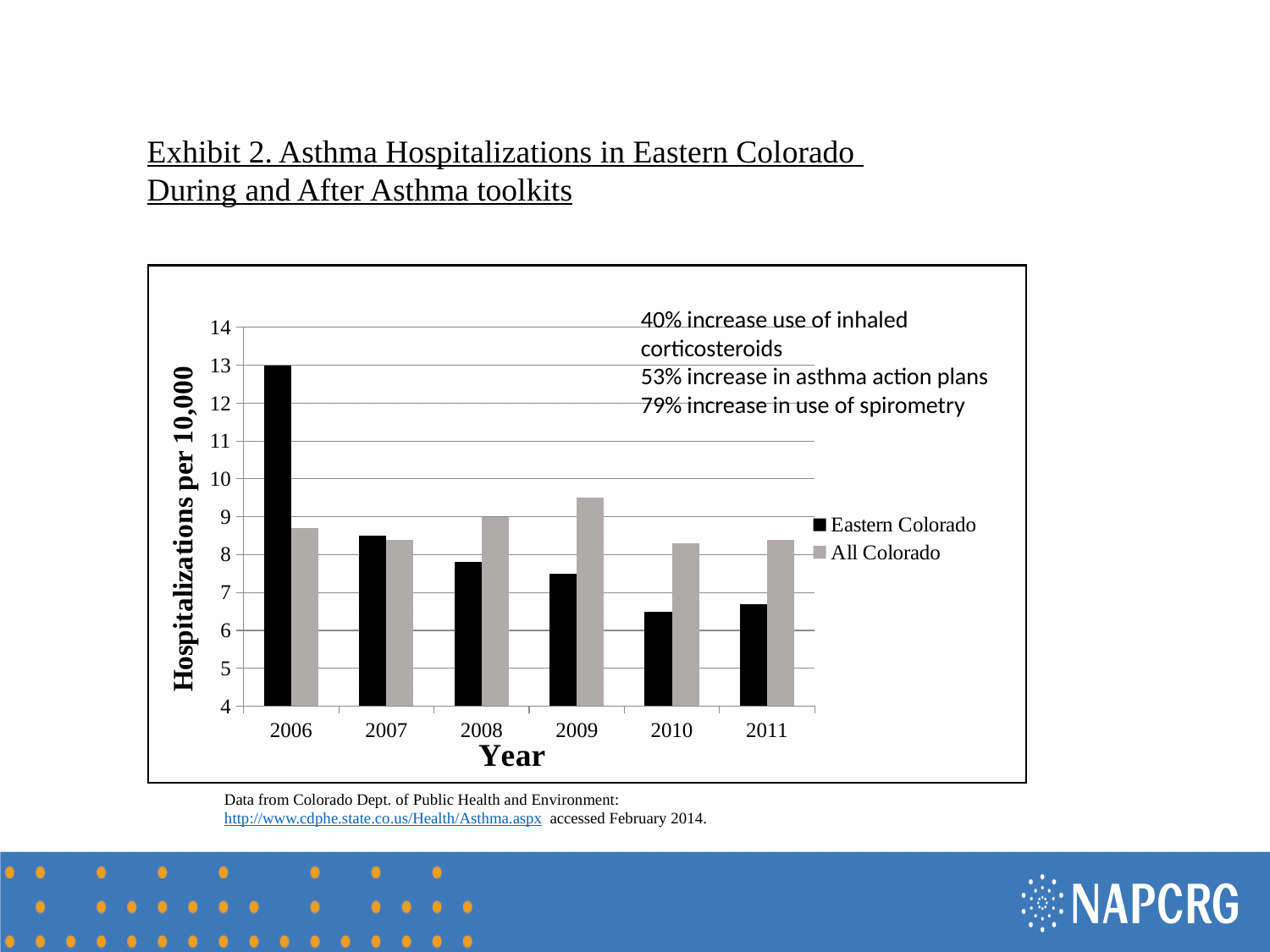
In which year is the Eastern Colorado value highest? 2006 In which year is the All Colorado value highest? 2009 How many years are shown on the x axis? 6 What is the All Colorado value for 2008? 9 How many series does the legend list? 2 What is the title of the y axis? Hospitalizations per 10,000 What is the Eastern Colorado value for 2006? 13 What kind of chart is shown on the slide? bar chart Is the All Colorado value for 2009 greater or less than 9? greater In 2009, which series has the larger value, Eastern Colorado or All Colorado? All Colorado Is the Eastern Colorado value for 2010 greater or less than 7? less In 2006, which series has the larger value, Eastern Colorado or All Colorado? Eastern Colorado